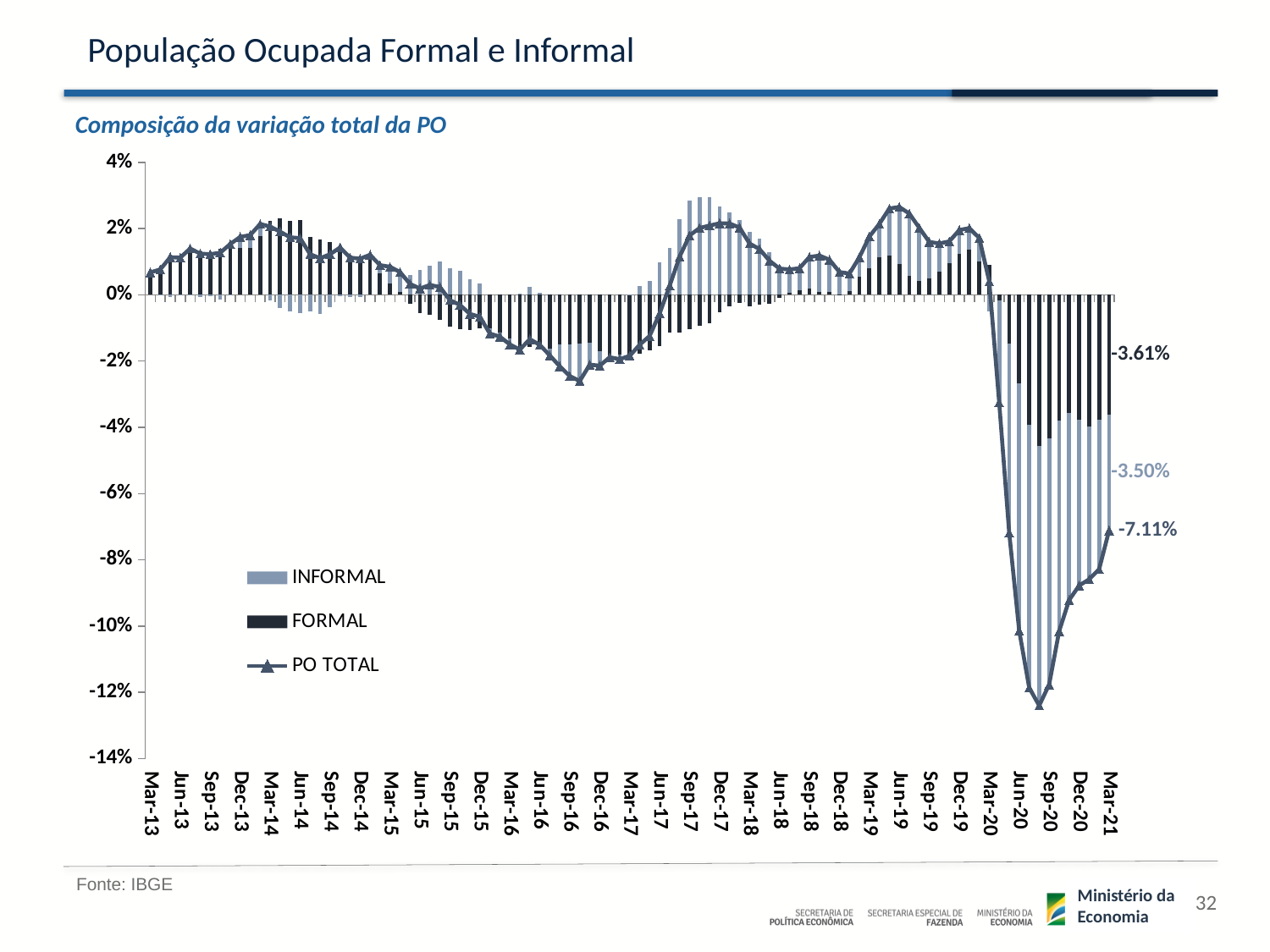
How many series does the legend list? 3 Is the PO TOTAL value at Sep-20 greater or less than -10%? less Does the PO TOTAL line rise or fall between Mar-20 and Sep-20? fall What is the data label shown for the FORMAL series at Mar-21? -3.61% What is the title of the chart? Composição da variação total da PO What value does the PO TOTAL line show at Mar-21? -7.11% What is the total of the stacked bar at Mar-21 (FORMAL plus INFORMAL)? -7.11% What is the data label shown for the INFORMAL series at Mar-21? -3.50% What kind of chart is shown on the slide? A combination chart with stacked bars and a line Which is higher, the PO TOTAL value at Jun-19 or at Mar-13? Jun-19 Is the PO TOTAL value at Sep-16 greater or less than -2%? less